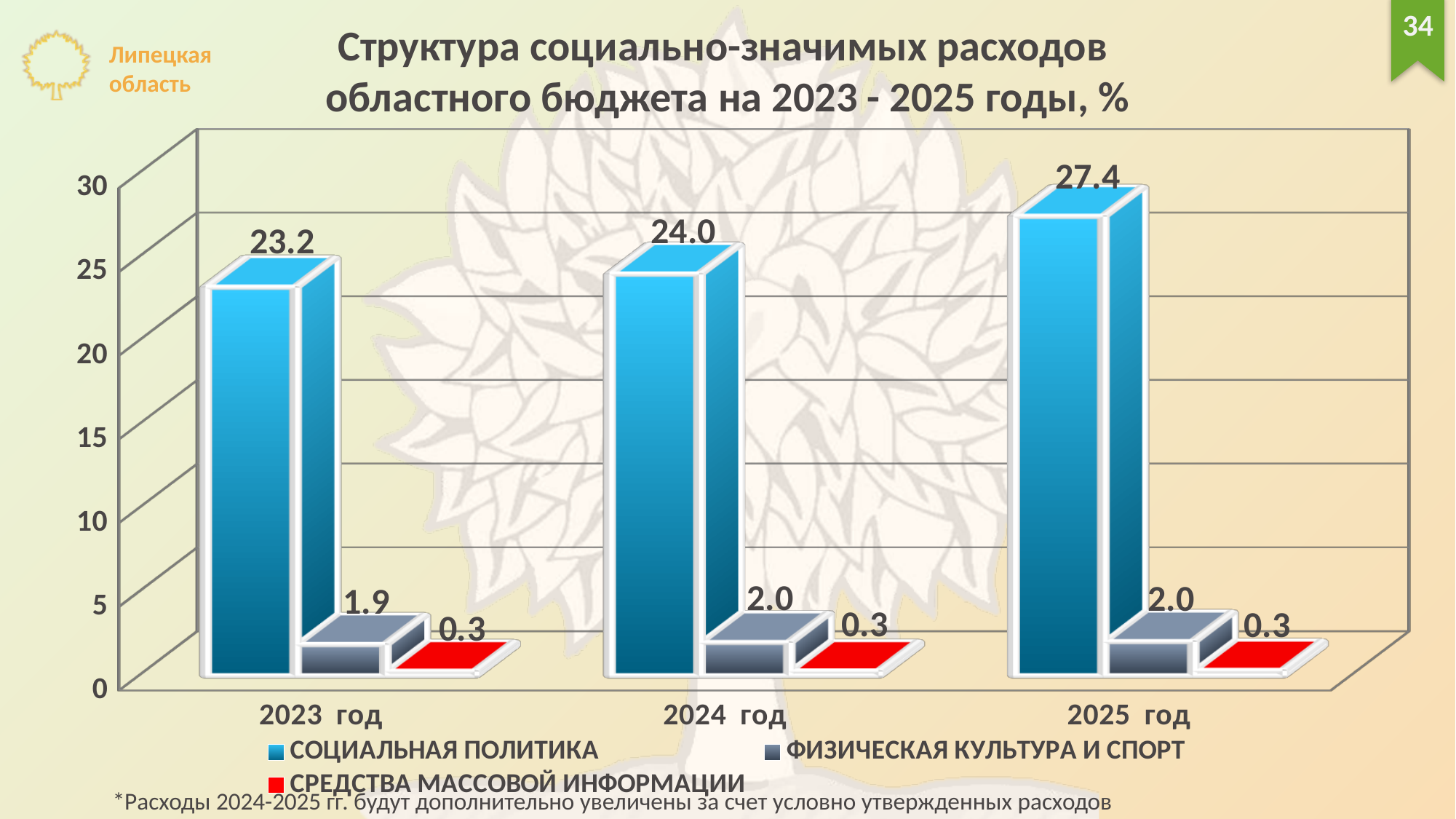
Is the value for СОЦИАЛЬНАЯ ПОЛИТИКА in 2025 год greater or less than 25? greater In which year is the value for ФИЗИЧЕСКАЯ КУЛЬТУРА И СПОРТ the lowest? 2023 год In which year is the value for СОЦИАЛЬНАЯ ПОЛИТИКА the highest? 2025 год What is the value for ФИЗИЧЕСКАЯ КУЛЬТУРА И СПОРТ in 2024 год? 2.0 What is the difference between the СОЦИАЛЬНАЯ ПОЛИТИКА values for 2025 год and 2023 год? 4.2 What kind of chart is shown on the slide? bar chart What is the value for СОЦИАЛЬНАЯ ПОЛИТИКА in 2023 год? 23.2 Which is larger: СОЦИАЛЬНАЯ ПОЛИТИКА in 2024 год or in 2023 год? 2024 год Does the value for СОЦИАЛЬНАЯ ПОЛИТИКА rise or fall from 2023 год to 2025 год? rise How many years are shown on the x axis? 3 How many series does the legend list? 3 What is the value for СРЕДСТВА МАССОВОЙ ИНФОРМАЦИИ in 2025 год? 0.3